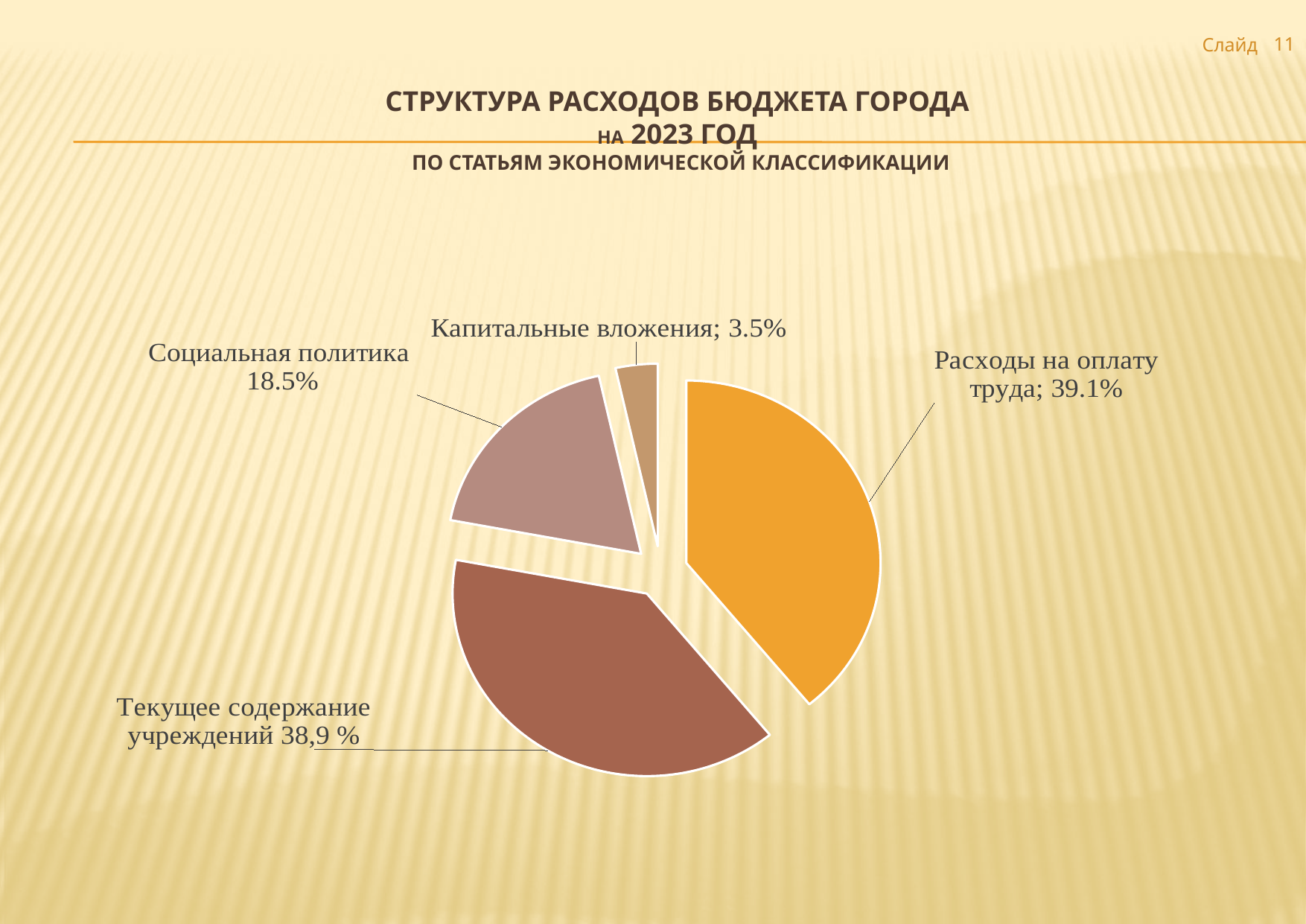
What share of the pie does Социальная политика have? 18.5% What colour is the slice for Расходы на оплату труда? Orange How many slices does the pie chart have? 4 What is the difference in percentage points between Расходы на оплату труда and Социальная политика? 20.6 What share of the pie does Капитальные вложения have? 3.5% What share of the pie does Расходы на оплату труда have? 39.1% Which category has the smallest slice of the pie? Капитальные вложения What share of the pie does Текущее содержание учреждений have? 38,9 % Which is larger: the slice for Социальная политика or the slice for Капитальные вложения? Социальная политика What is the difference in percentage points between Социальная политика and Капитальные вложения? 15.0 Which category has the largest slice of the pie? Расходы на оплату труда What kind of chart is shown on the slide? Pie chart